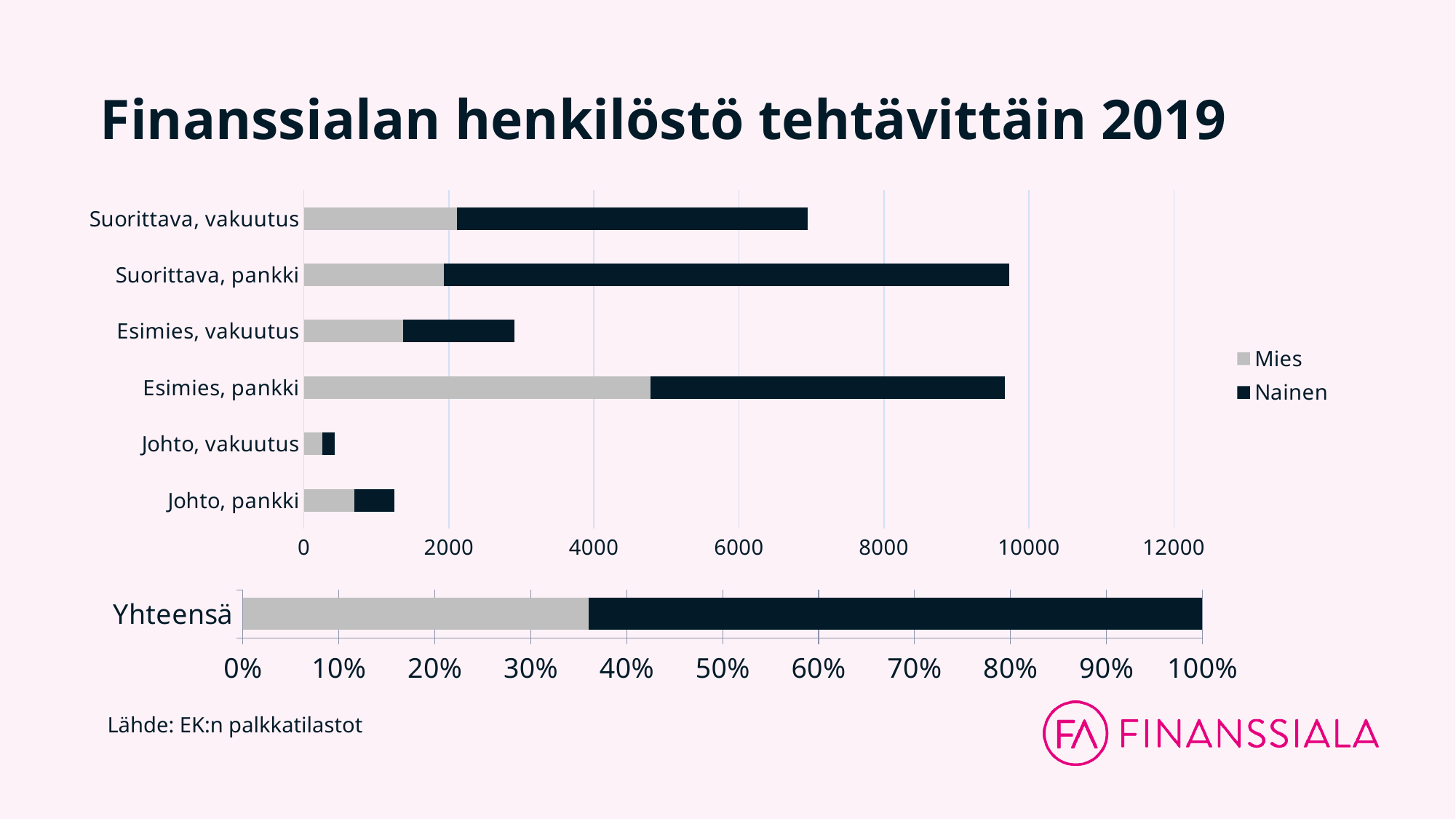
In the top chart, is the Mies value for Esimies, pankki greater or less than 4000? greater In the top chart, which has the larger total: Esimies, vakuutus or Suorittava, vakuutus? Suorittava, vakuutus In the top chart, is the total for Suorittava, vakuutus greater or less than 6000? greater In the top chart, which has the larger total: Johto, pankki or Johto, vakuutus? Johto, pankki In the top chart, what kind of chart is used? bar chart In the top chart, how many series does the legend list? 2 In the top chart, how many categories are shown on the vertical axis? 6 In the top chart, is the total for Esimies, vakuutus greater or less than 4000? less What is the title of the slide's chart? Finanssialan henkilöstö tehtävittäin 2019 In the top chart, which category has the lowest total? Johto, vakuutus